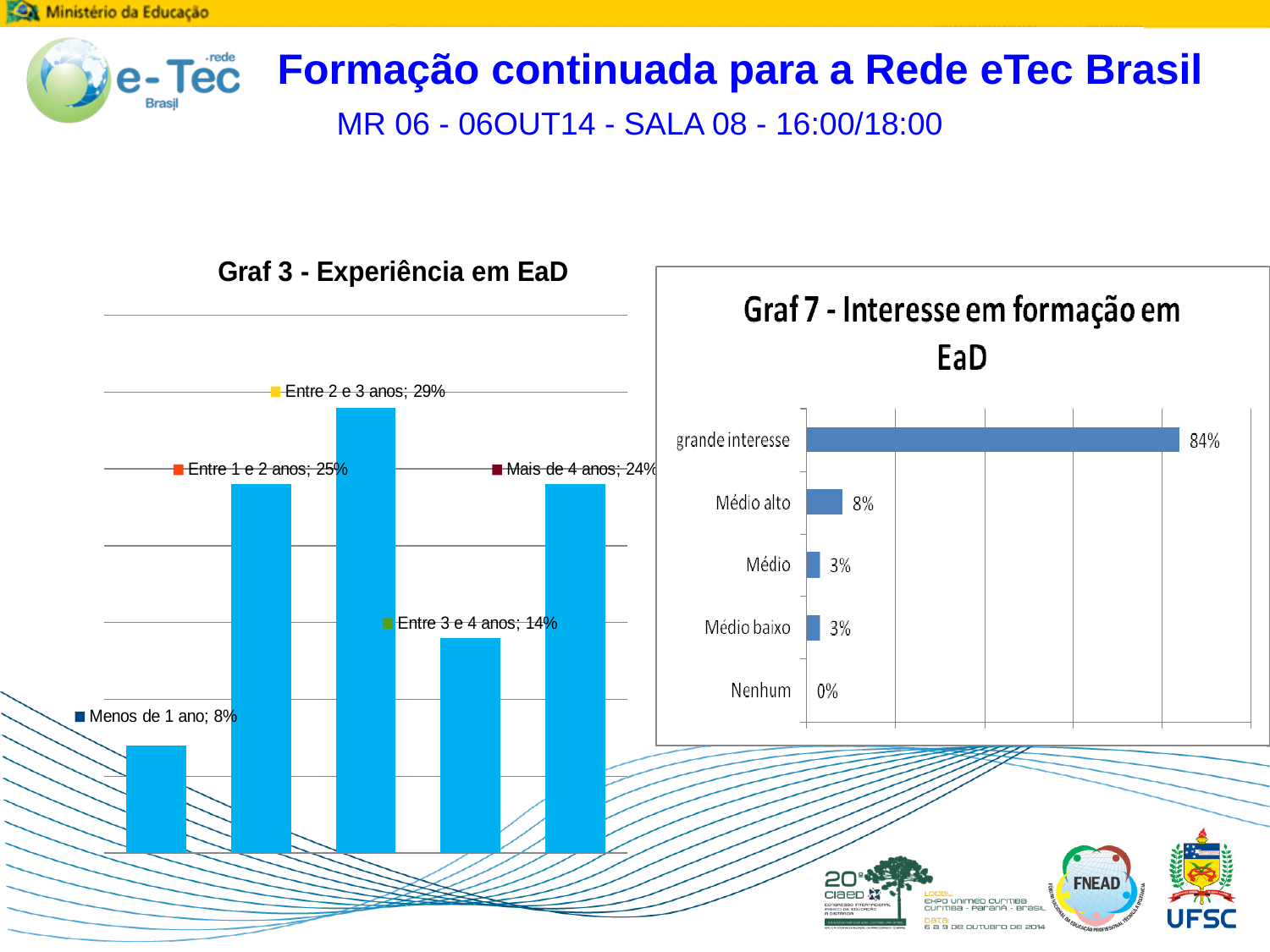
In the chart 'Graf 3 - Experiência em EaD', what is the value for 'Menos de 1 ano'? 8% In the chart 'Graf 7 - Interesse em formação em EaD', which is larger: 'Médio alto' or 'Médio'? Médio alto In the chart 'Graf 7 - Interesse em formação em EaD', what is the difference between 'grande interesse' and 'Médio alto'? 76% In the chart 'Graf 7 - Interesse em formação em EaD', what is the value for 'grande interesse'? 84% What kind of chart is 'Graf 3 - Experiência em EaD'? Bar chart In the chart 'Graf 3 - Experiência em EaD', what is the difference between 'Entre 1 e 2 anos' and 'Entre 3 e 4 anos'? 11% In the chart 'Graf 3 - Experiência em EaD', which category has the lowest value? Menos de 1 ano In the chart 'Graf 3 - Experiência em EaD', how many categories are shown? 5 In the chart 'Graf 7 - Interesse em formação em EaD', which category has the lowest value? Nenhum In the chart 'Graf 7 - Interesse em formação em EaD', what is the value for 'Médio alto'? 8% In the chart 'Graf 3 - Experiência em EaD', what is the value for 'Entre 2 e 3 anos'? 29% In the chart 'Graf 3 - Experiência em EaD', which category has the highest value? Entre 2 e 3 anos